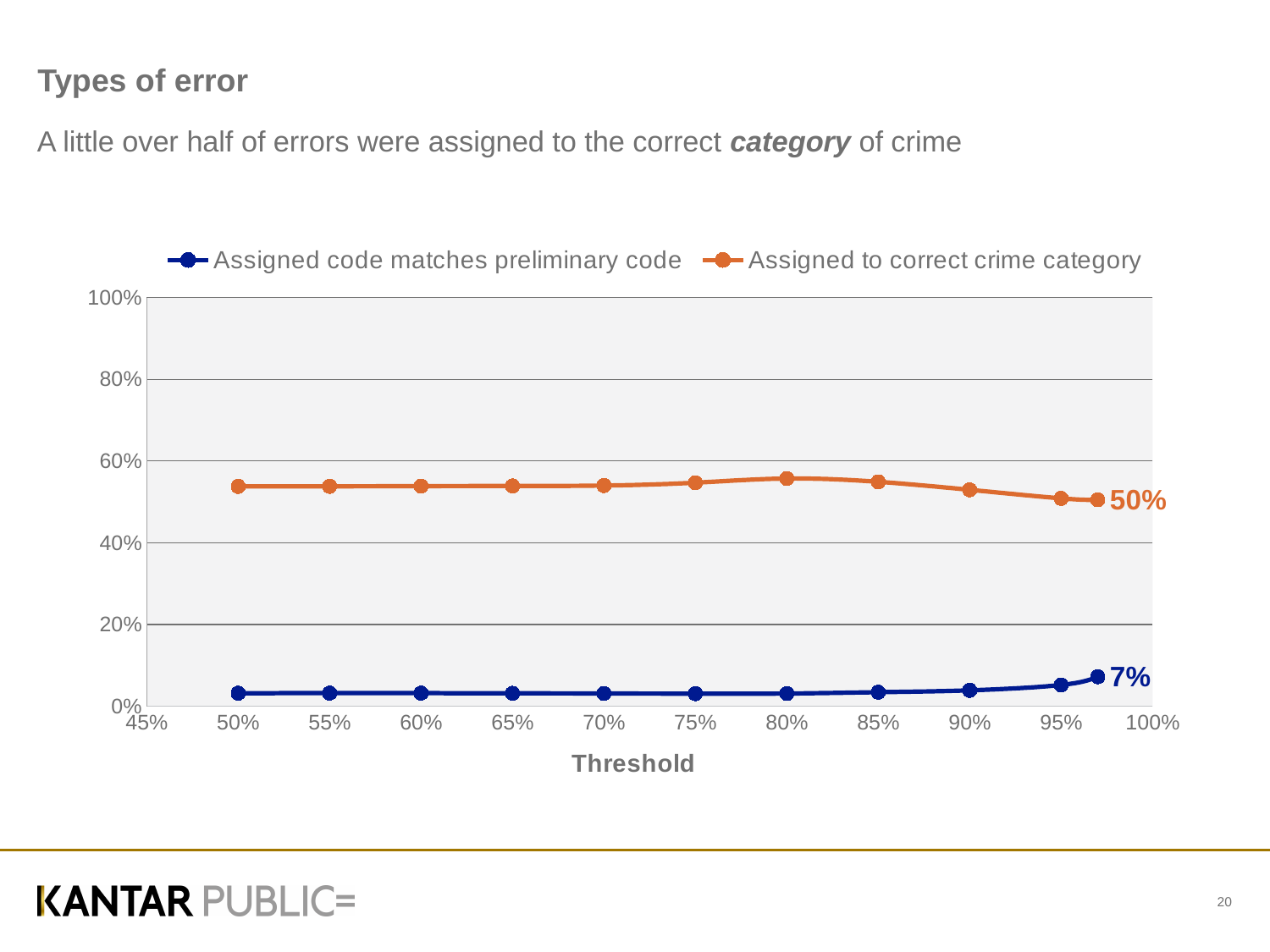
How many series does the legend list? 2 Does the 'Assigned to correct crime category' line rise or fall between the 80% and 95% thresholds? Fall What colour is the 'Assigned to correct crime category' line? Orange What is the labelled final value of the 'Assigned code matches preliminary code' line? 7% Is the value for 'Assigned code matches preliminary code' at the 50% threshold greater or less than 20%? less How many data points are plotted on each line? 11 What kind of chart is shown on the slide? Line chart Is the value for 'Assigned to correct crime category' at the 80% threshold greater or less than 40%? greater What is the difference between the labelled final values of the two lines (50% and 7%)? 43 percentage points What is the title of the x axis? Threshold What is the labelled final value of the 'Assigned to correct crime category' line? 50% At the final labelled point, which series has the larger value: 'Assigned to correct crime category' or 'Assigned code matches preliminary code'? Assigned to correct crime category